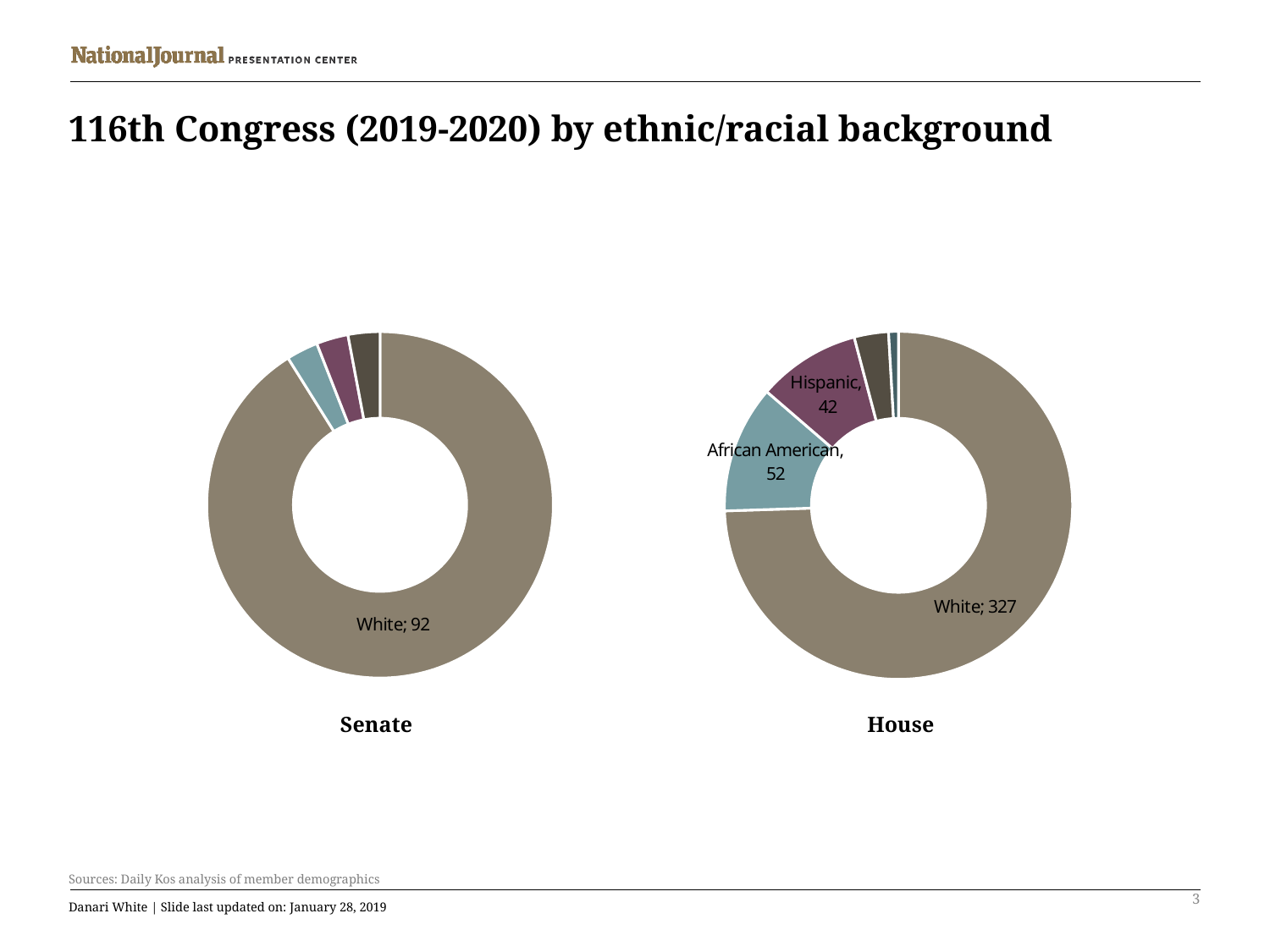
What is the title of the slide containing the two charts? 116th Congress (2019-2020) by ethnic/racial background In the House chart, what value is shown for Hispanic? 42 What is the difference between the White value in the House chart and the White value in the Senate chart? 235 What kind of chart is used for the Senate? Doughnut (pie) chart In the Senate chart, which category has the largest slice? White In the House chart, what value is shown for White? 327 In the House chart, which category has the largest slice? White How many slices does the House chart have? 5 In the Senate chart, what value is shown for White? 92 In the House chart, what is the difference between the African American and Hispanic values? 10 In the House chart, what value is shown for African American? 52 In the House chart, which is larger, African American or Hispanic? African American